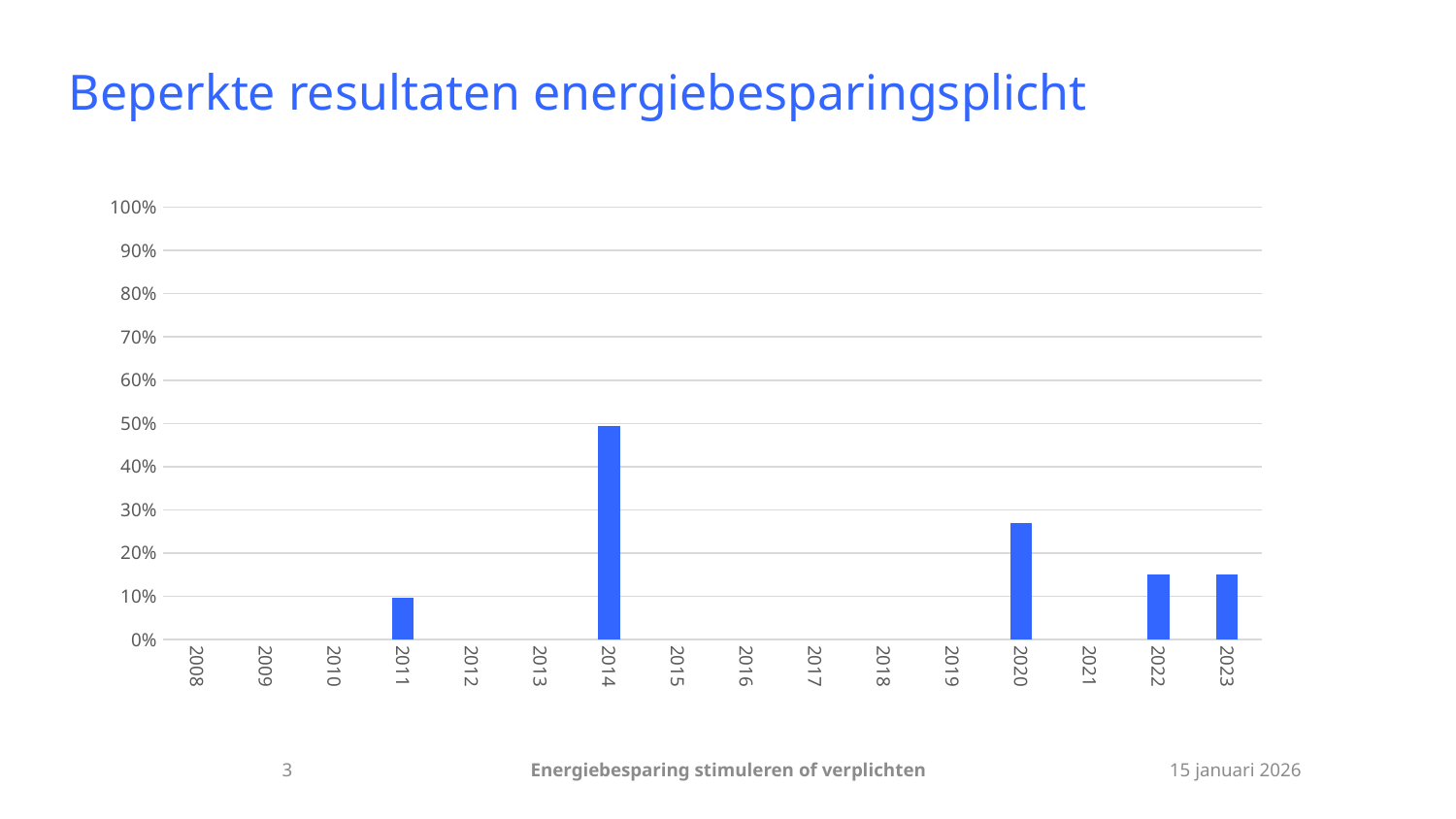
Which is larger, the value for 2014 or the value for 2020? 2014 Which year has the highest bar in the chart? 2014 What is the first year shown on the x axis of the chart? 2008 Which is larger, the value for 2020 or the value for 2011? 2020 How many years are shown on the x axis of the chart? 16 Is the value for 2011 greater or less than 20%? less What kind of chart is shown on the slide? bar chart Is the value for 2014 greater or less than 40%? greater Is the value for 2022 greater or less than 10%? greater